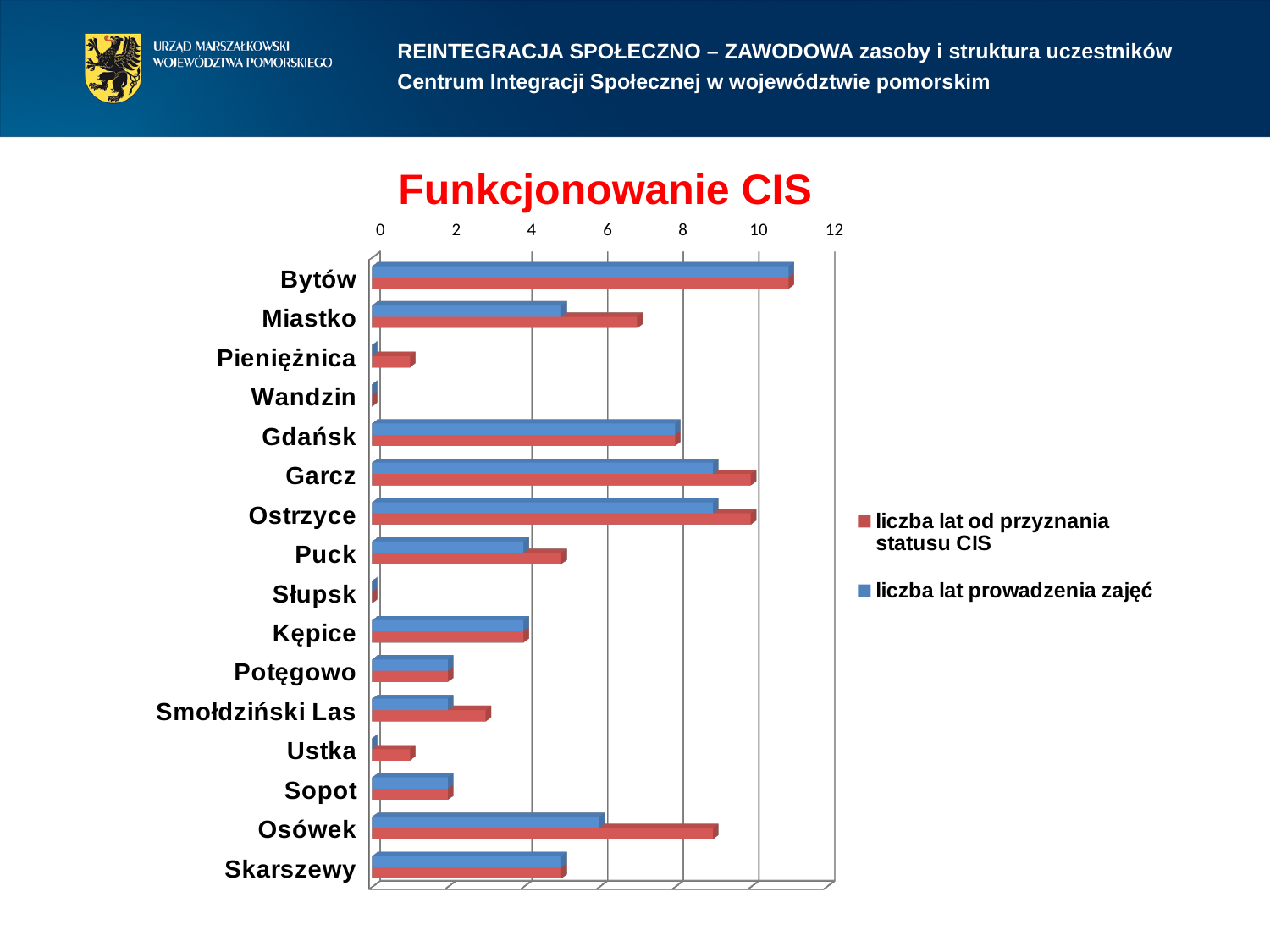
How many series does the legend list? 2 For Osówek, which is larger: 'liczba lat od przyznania statusu CIS' or 'liczba lat prowadzenia zajęć'? liczba lat od przyznania statusu CIS How many categories (locations) are shown on the chart? 16 Which has a larger value for 'liczba lat od przyznania statusu CIS': Garcz or Gdańsk? Garcz Which location has the highest value for 'liczba lat prowadzenia zajęć'? Bytów Is the value of 'liczba lat prowadzenia zajęć' for Osówek greater or less than 4? greater Is the value of 'liczba lat od przyznania statusu CIS' for Bytów greater or less than 10? greater Which colour represents 'liczba lat prowadzenia zajęć' in the chart? blue What is the title of the chart? Funkcjonowanie CIS Which location has the highest value for 'liczba lat od przyznania statusu CIS'? Bytów Is the value of 'liczba lat od przyznania statusu CIS' for Miastko greater or less than 6? greater What type of chart is shown on the slide? bar chart